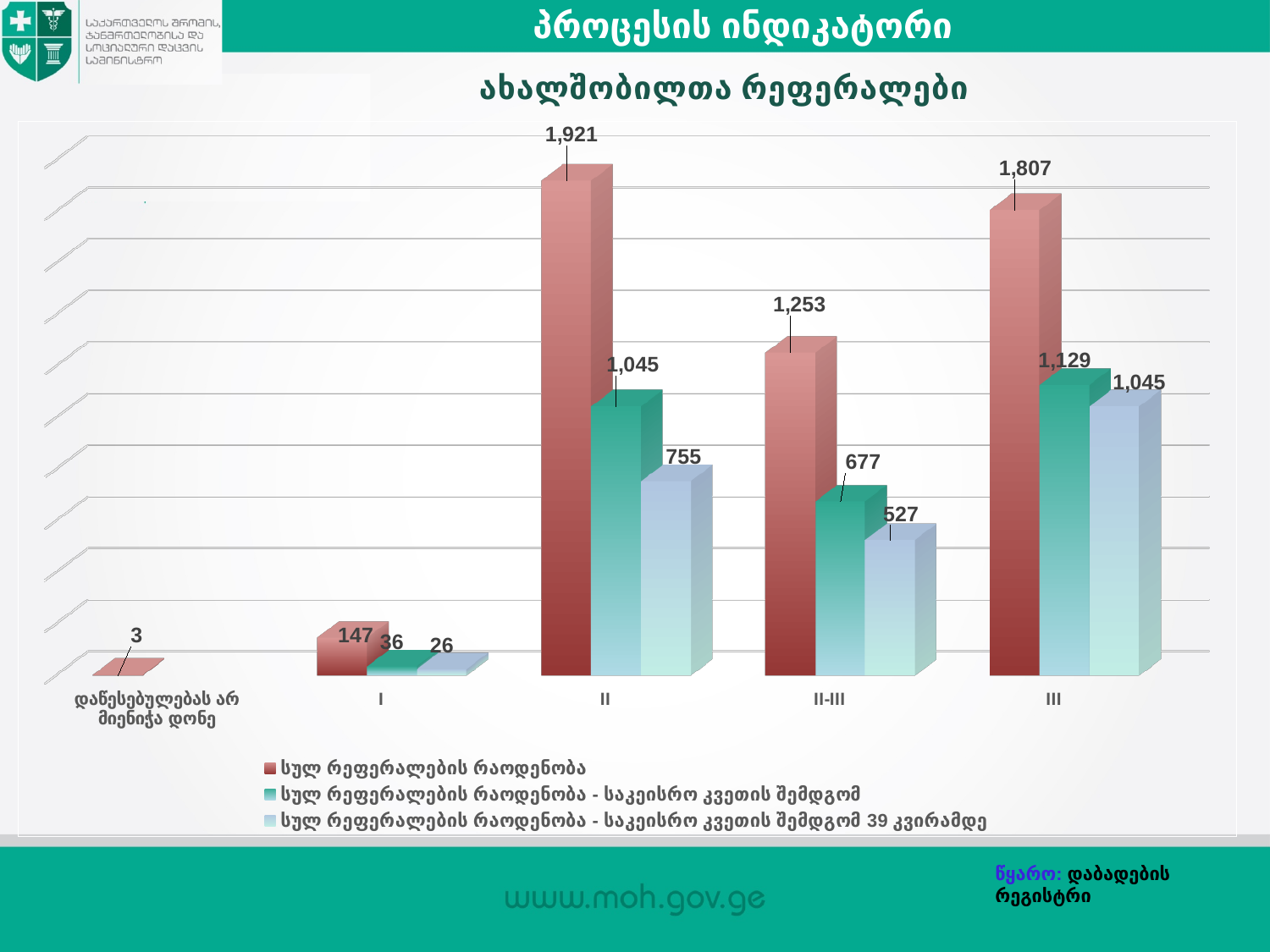
Which level has the highest total number of referrals (red series)? II What is the total number of referrals (სულ რეფერალების რაოდენობა) for level II? 1,921 What is the title of the chart? ახალშობილთა რეფერალები What is the value of the 'საკეისრო კვეთის შემდგომ' series for level II-III? 677 How many series does the legend list? 3 Which is larger: the 'საკეისრო კვეთის შემდგომ' value for level II or for level III? level III What is the difference between the total referrals for level II and level III? 114 What is the difference between the 'საკეისრო კვეთის შემდგომ' and 'საკეისრო კვეთის შემდგომ 39 კვირამდე' values for level II? 290 What is the value of the 'საკეისრო კვეთის შემდგომ 39 კვირამდე' series for level III? 1,045 How many categories are shown on the x axis? 5 What kind of chart is shown on the slide? bar chart Which category has the lowest total number of referrals (red series)? დაწესებულებას არ მიენიჭა დონე